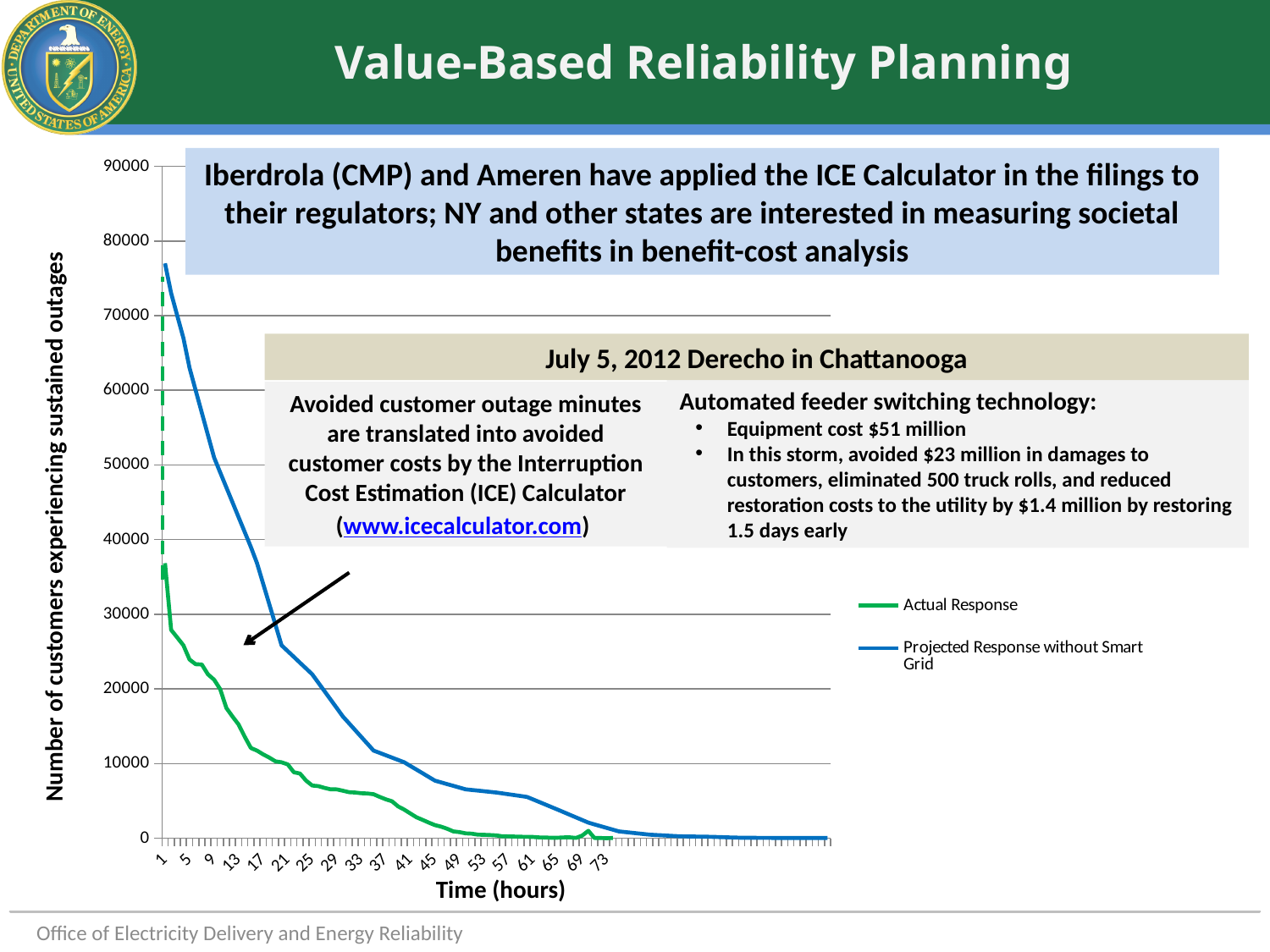
Is the value for Actual Response at hour 37 greater or less than 10000? less Is the value for Projected Response without Smart Grid at hour 1 greater or less than 70000? greater Do the values of the Projected Response without Smart Grid series rise or fall as time increases along the x axis? Fall At hour 9, which series has the higher value: Actual Response or Projected Response without Smart Grid? Projected Response without Smart Grid What are the two series named in the chart's legend? Actual Response; Projected Response without Smart Grid Is the value for Projected Response without Smart Grid at hour 21 greater or less than 20000? greater How many series does the chart's legend list? 2 Which series reaches zero customers experiencing sustained outages earlier in time? Actual Response What kind of chart is shown on the slide? Line chart What is the title of the chart's x axis? Time (hours) Do the values of the Actual Response series rise or fall as time increases along the x axis? Fall